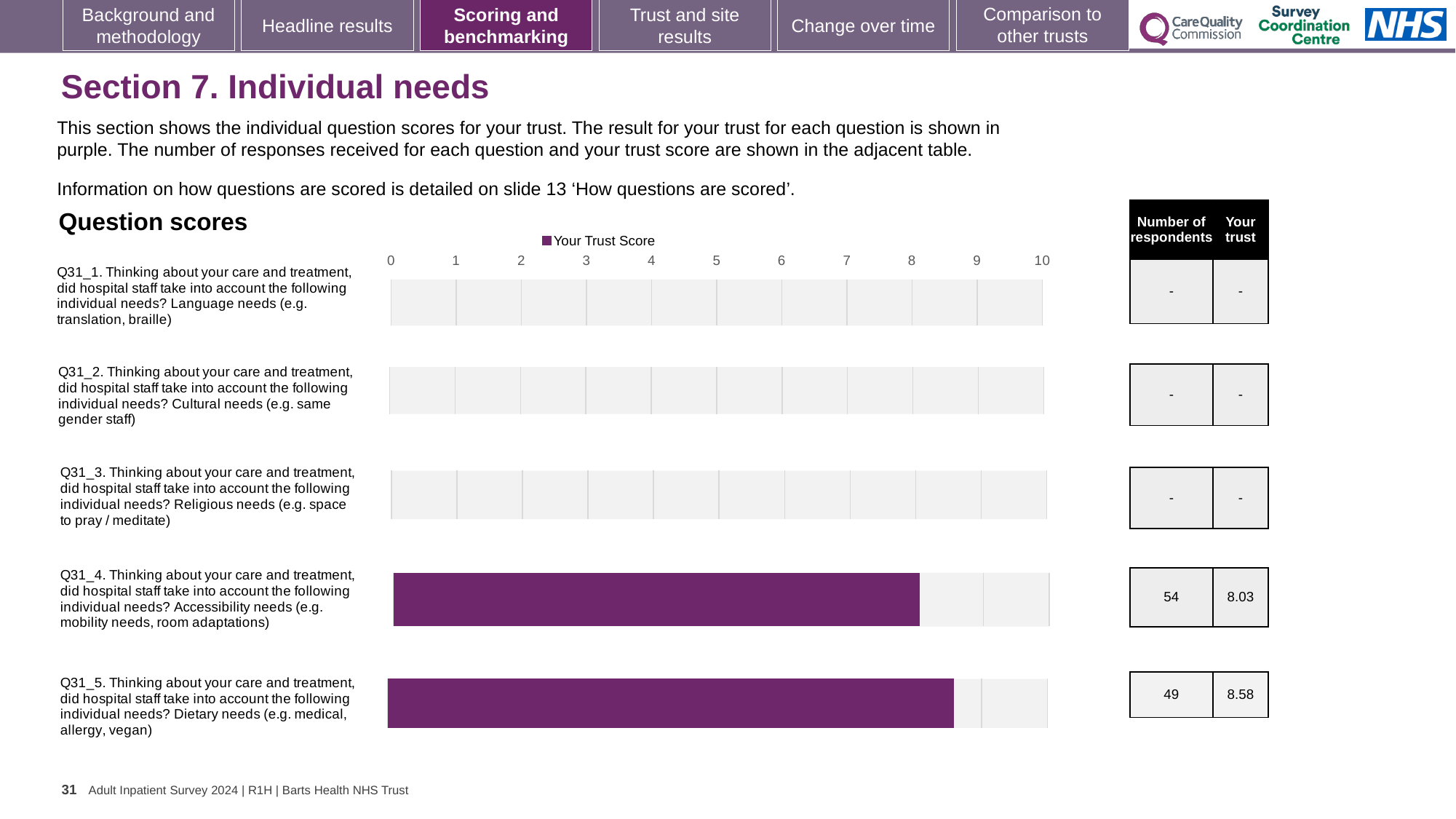
Which question has the higher trust score, Q31_4 (Accessibility needs) or Q31_5 (Dietary needs)? Q31_5 (Dietary needs) How many questions are listed in the Question scores chart? 5 What is the trust score for Q31_5 (Dietary needs)? 8.58 Is the trust score for Q31_4 (Accessibility needs) greater or less than 9? less What is the difference between the trust scores for Q31_5 (Dietary needs) and Q31_4 (Accessibility needs)? 0.55 How many respondents answered Q31_5 (Dietary needs)? 49 How many questions in the Question scores chart have a plotted trust score bar? 2 What is the maximum value shown on the score axis of the chart? 10 How many respondents answered Q31_4 (Accessibility needs)? 54 Is the trust score for Q31_5 (Dietary needs) greater or less than 8? greater What is the trust score for Q31_4 (Accessibility needs)? 8.03 What type of chart is used to show the question scores? Bar chart